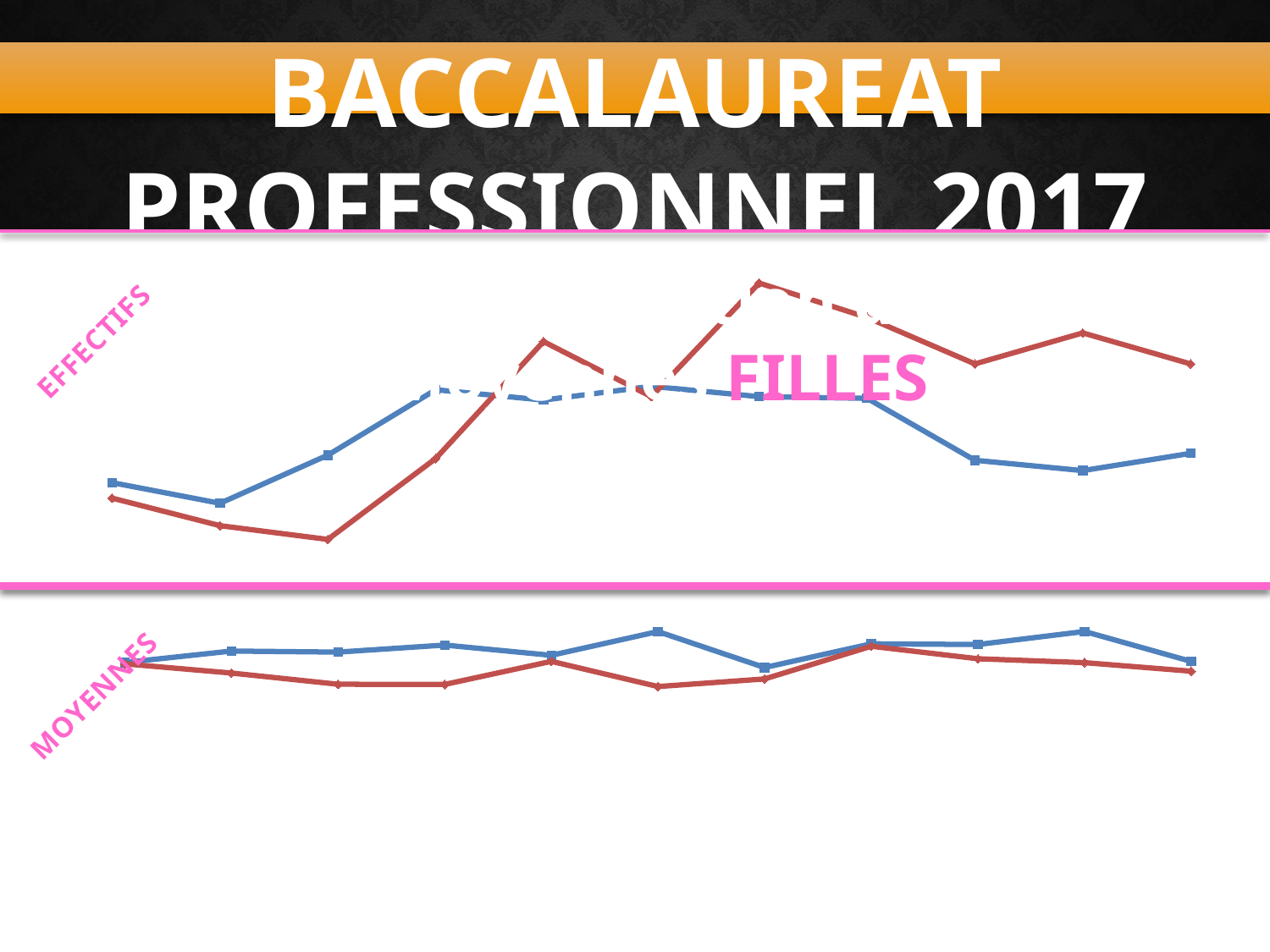
How many data points does each line have in the top chart labelled EFFECTIFS? 11 What kind of chart is the top chart labelled EFFECTIFS? line chart In the top chart labelled EFFECTIFS, which line has the lowest point, the blue line or the red line? the red line How many lines are plotted in the top chart labelled EFFECTIFS? 2 In the top chart labelled EFFECTIFS, at the last point on the right, which line is higher, blue or red? red In the bottom chart labelled MOYENNES, at the first point on the left, which line is higher, blue or red? blue In the top chart labelled EFFECTIFS, at the first point on the left, which line is higher, blue or red? blue In the top chart labelled EFFECTIFS, which line reaches the highest point, the blue line or the red line? the red line What kind of chart is the bottom chart labelled MOYENNES? line chart What are the two colours of the lines in the bottom chart labelled MOYENNES? blue and red How many data points does each line have in the bottom chart labelled MOYENNES? 11 How many lines are plotted in the bottom chart labelled MOYENNES? 2